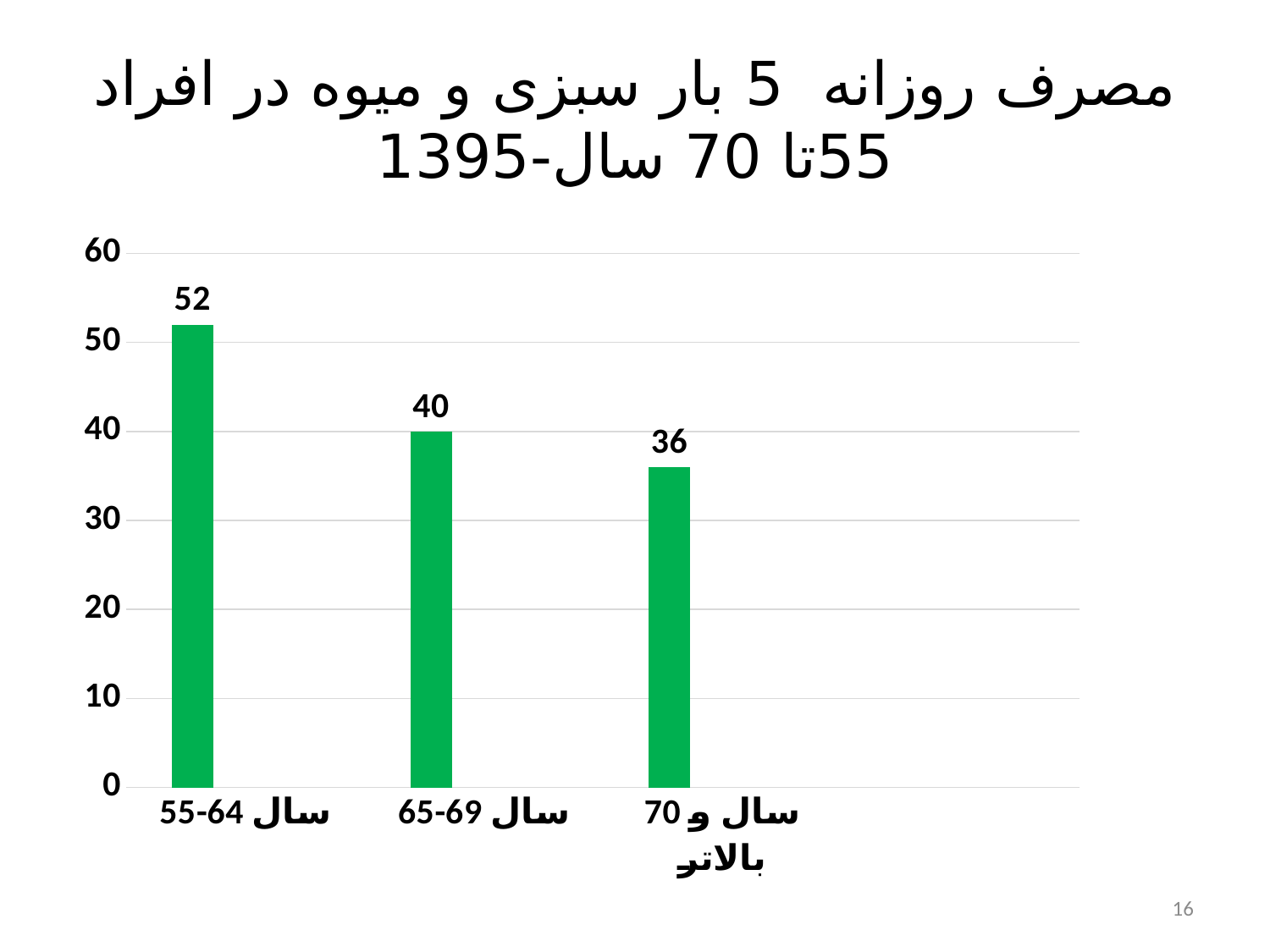
What is the value for the 70 سال و بالاتر age group? 36 Which age group has the lowest value? 70 سال و بالاتر How many age groups are shown in the chart? 3 Which is larger, the value for 55-64 سال or the value for 65-69 سال? 55-64 سال Do the values rise or fall as the age groups get older along the x axis? fall What kind of chart is shown on the slide? bar chart What is the difference between the values for 65-69 سال and 70 سال و بالاتر? 4 Is the value for 70 سال و بالاتر greater or less than 40? less What is the value for the 55-64 سال age group? 52 What is the difference between the values for 55-64 سال and 70 سال و بالاتر? 16 Which age group has the highest value? 55-64 سال What is the value for the 65-69 سال age group? 40